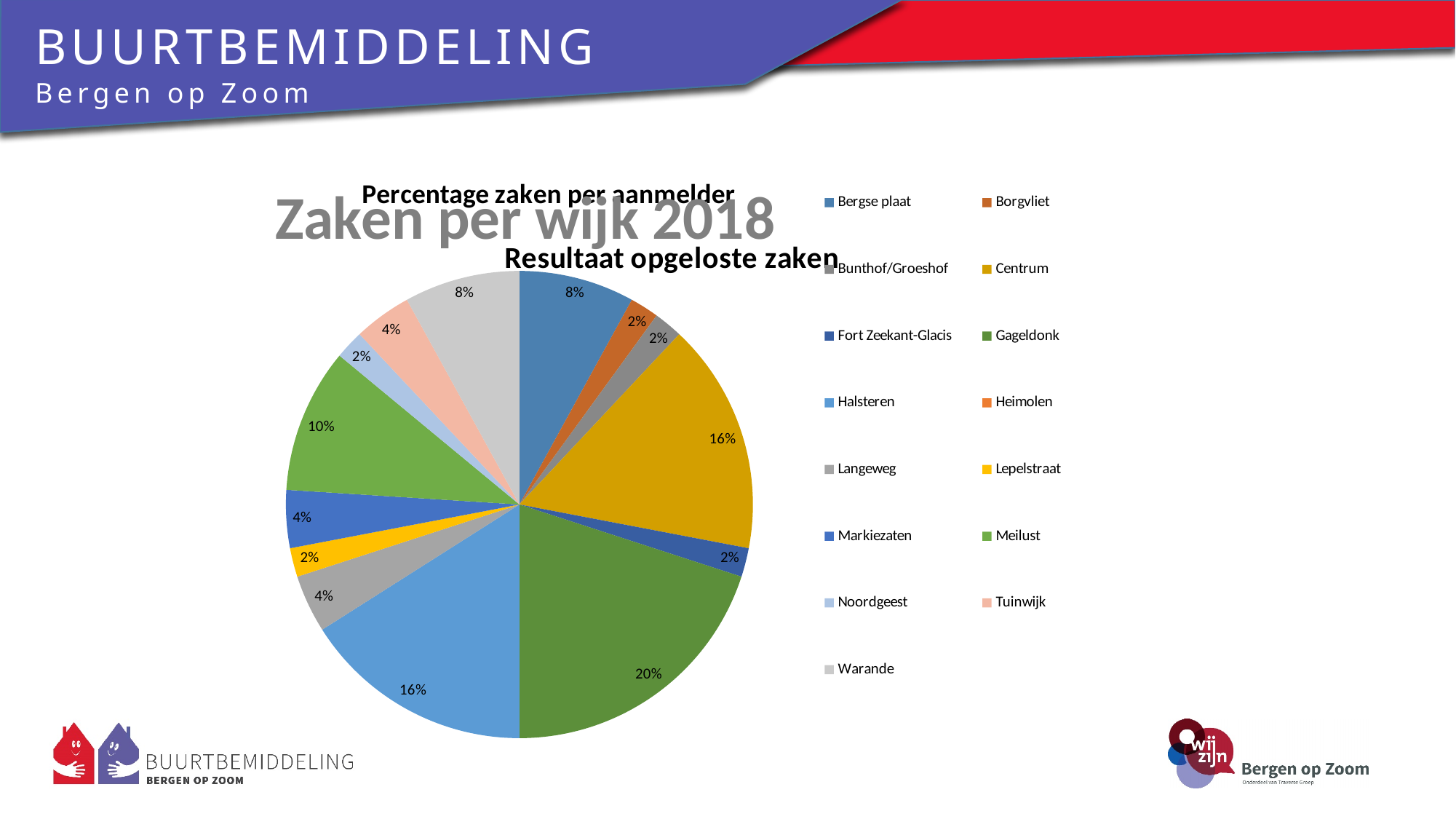
What percentage does the Centrum slice show? 16% Which is larger, the Gageldonk slice or the Meilust slice? Gageldonk What is the difference in percentage points between the Gageldonk slice and the Meilust slice? 10 How many categories are listed in the legend? 15 What percentage does the Gageldonk slice show? 20% What percentage does the Bergse plaat slice show? 8% What type of chart is shown on the slide? Pie chart Which category has the largest slice of the pie? Gageldonk What percentage does the Meilust slice show? 10% What percentage does the Halsteren slice show? 16% What percentage does the Warande slice show? 8% What colour is used for Centrum in the legend? Gold/yellow